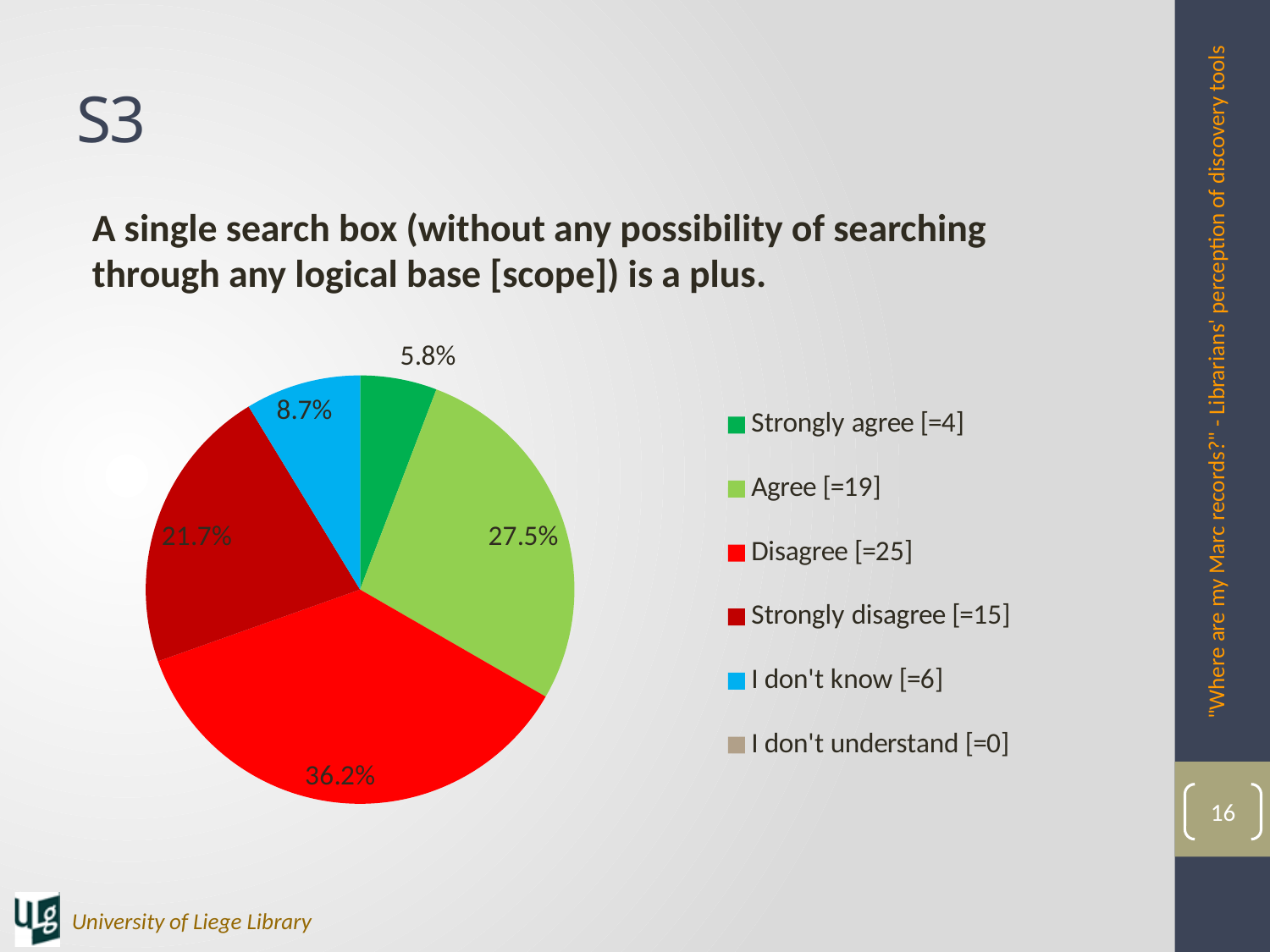
Which is larger, the share for Agree or the share for Strongly disagree? Agree What percentage of the pie does the Disagree slice represent? 36.2% What percentage of the pie does the Strongly disagree slice represent? 21.7% What percentage of the pie does the Agree slice represent? 27.5% Which response category has the largest slice of the pie? Disagree Which response category with a visible slice has the smallest share of the pie? Strongly agree How many entries does the legend list? 6 How many respondents chose Strongly disagree according to the legend? 15 What kind of chart is shown on the slide? pie chart How many respondents chose Disagree according to the legend? 25